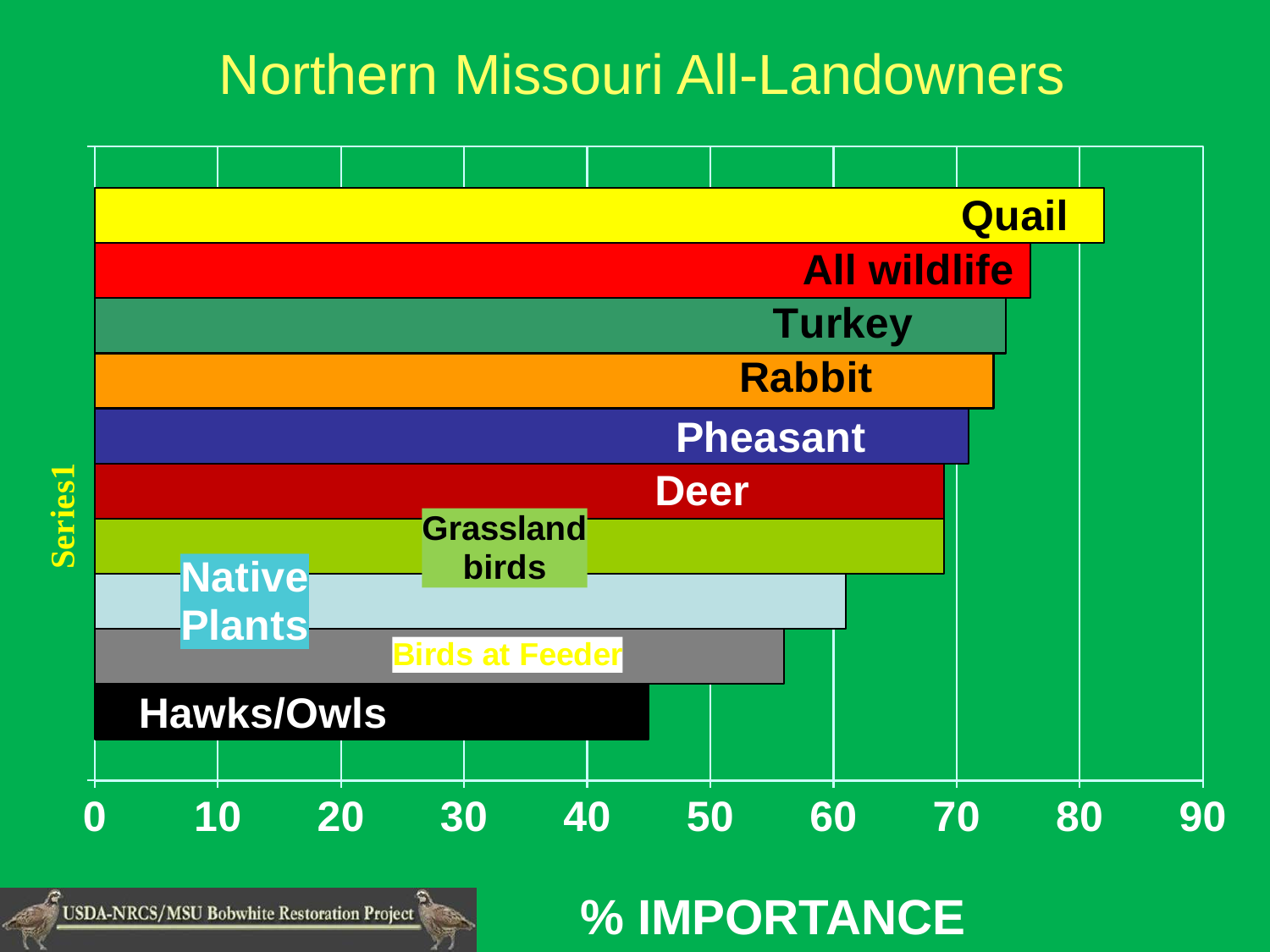
What kind of chart is shown on the slide? bar chart How many categories (bars) are plotted in the chart? 10 Is the value for All wildlife greater or less than 80? less Is the value for Quail greater or less than 80? greater What is the title of the chart? Northern Missouri All-Landowners What is the label on the horizontal axis of the chart? % IMPORTANCE Is the value for Turkey greater or less than 70? greater Which category has the highest % importance? Quail Which has a higher % importance, Deer or Native Plants? Deer Which category has the lowest % importance? Hawks/Owls